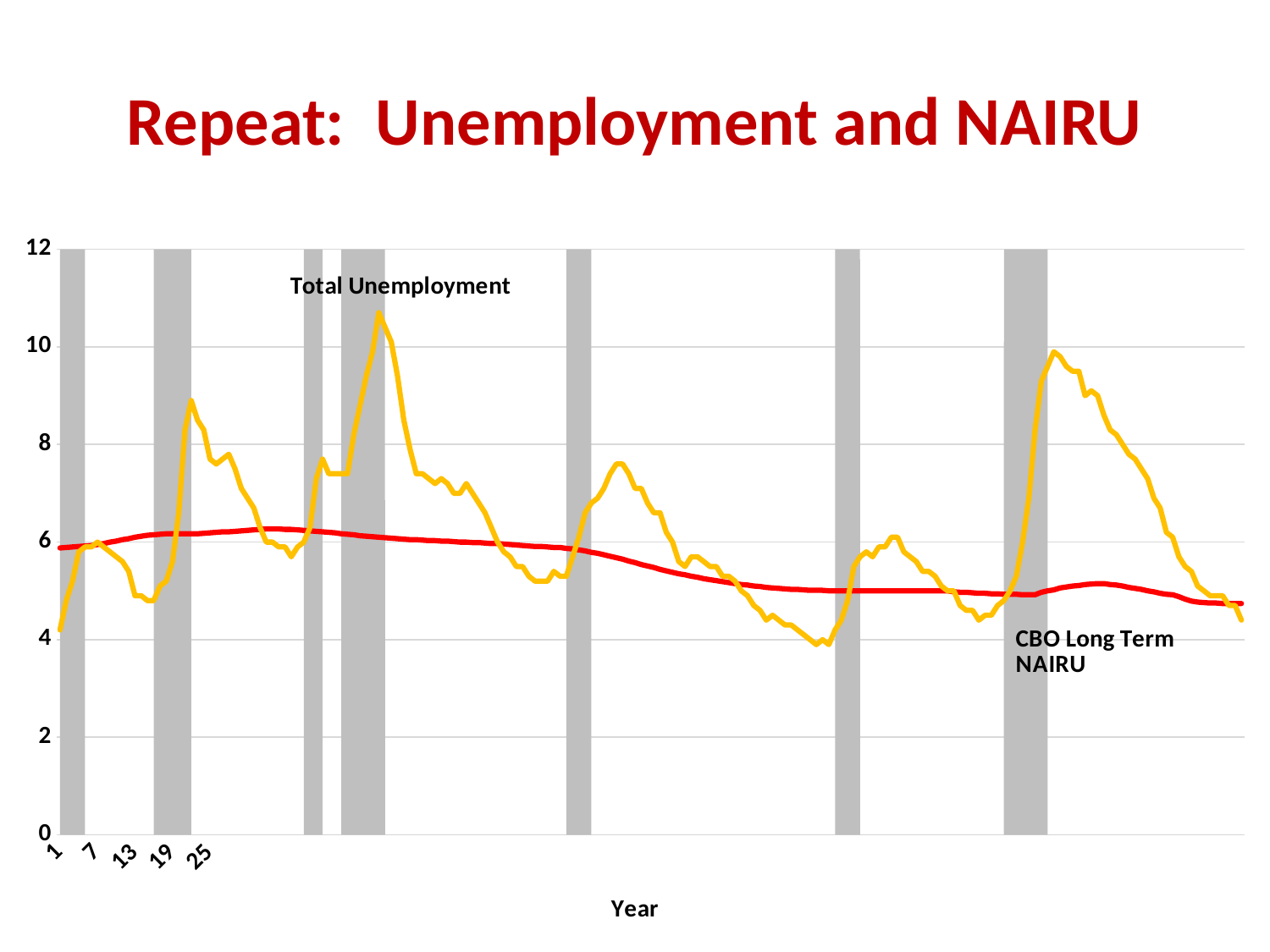
At year 1, which series has the higher value, Total Unemployment or CBO Long Term NAIRU? CBO Long Term NAIRU Does the CBO Long Term NAIRU line generally rise or fall from the left of the chart to the right? Fall Is the lowest value of Total Unemployment greater or less than 6? less What colour is the Total Unemployment line? Yellow Is the highest value of Total Unemployment greater or less than 10? greater How many data series are plotted on the chart? 3 Is the highest value of CBO Long Term NAIRU greater or less than 8? less At the highest peak of Total Unemployment, which series is higher, Total Unemployment or CBO Long Term NAIRU? Total Unemployment What kind of chart is shown on the slide? Line chart Which series reaches the higher maximum value, Total Unemployment or CBO Long Term NAIRU? Total Unemployment What is the title of the slide? Repeat: Unemployment and NAIRU